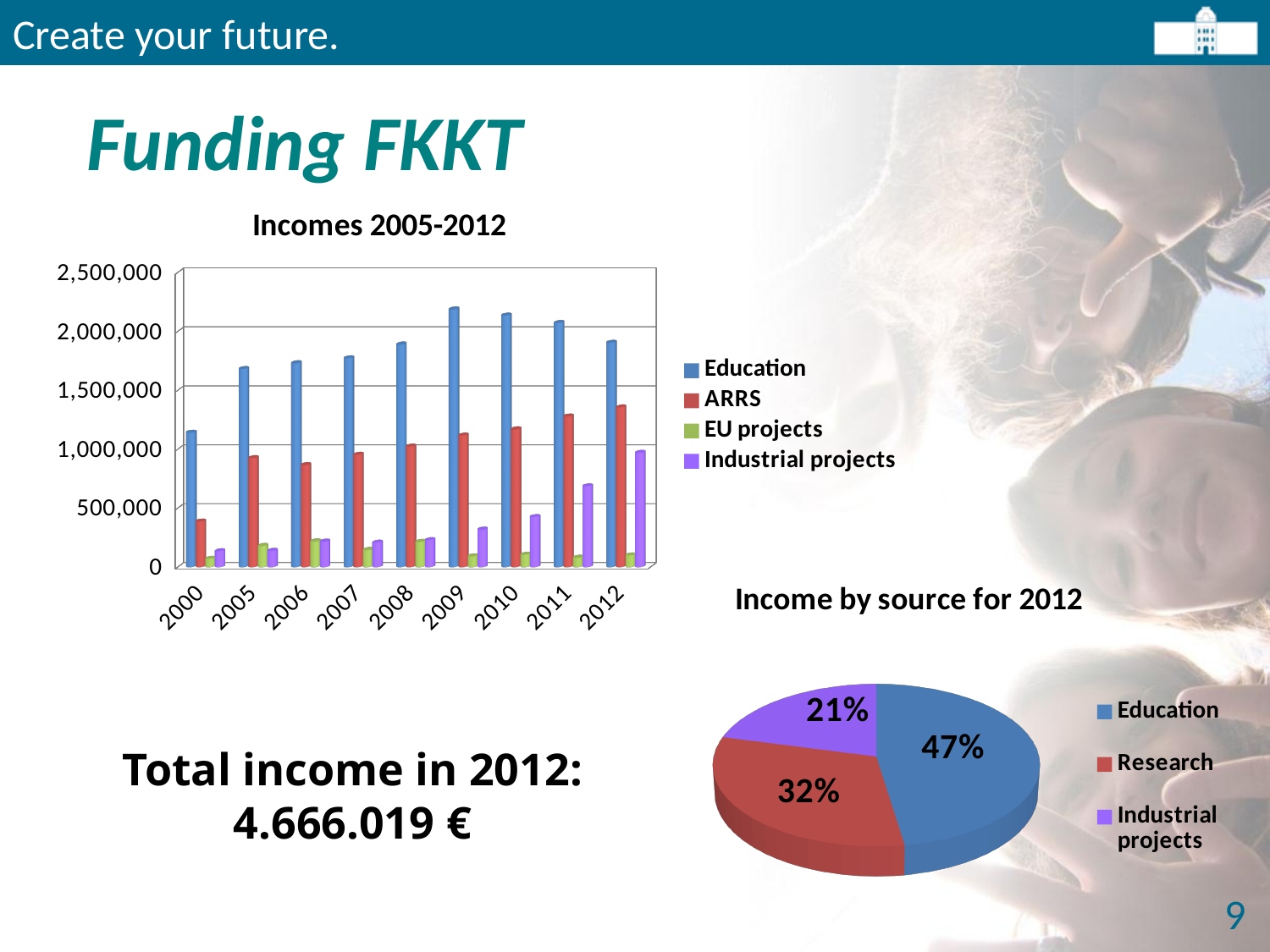
In the 'Income by source for 2012' pie chart, which source has the smallest share? Industrial projects How many series does the legend of the 'Incomes 2005-2012' chart list? 4 What kind of chart is the 'Incomes 2005-2012' chart? bar chart In the 'Income by source for 2012' pie chart, what share does Education have? 47% How many years are shown on the x axis of the 'Incomes 2005-2012' chart? 9 In the 'Incomes 2005-2012' chart, which year has the highest Industrial projects value? 2012 In the 'Incomes 2005-2012' chart, which is larger in 2012: Education or ARRS? Education In the 'Incomes 2005-2012' chart, which year has the lowest ARRS value? 2000 In the 'Incomes 2005-2012' chart, is the Education value for 2009 greater or less than 2,000,000? greater In the 'Income by source for 2012' pie chart, what is the difference between the Education and Research shares? 15% In the 'Incomes 2005-2012' chart, do the ARRS values generally rise or fall from 2005 to 2012? rise